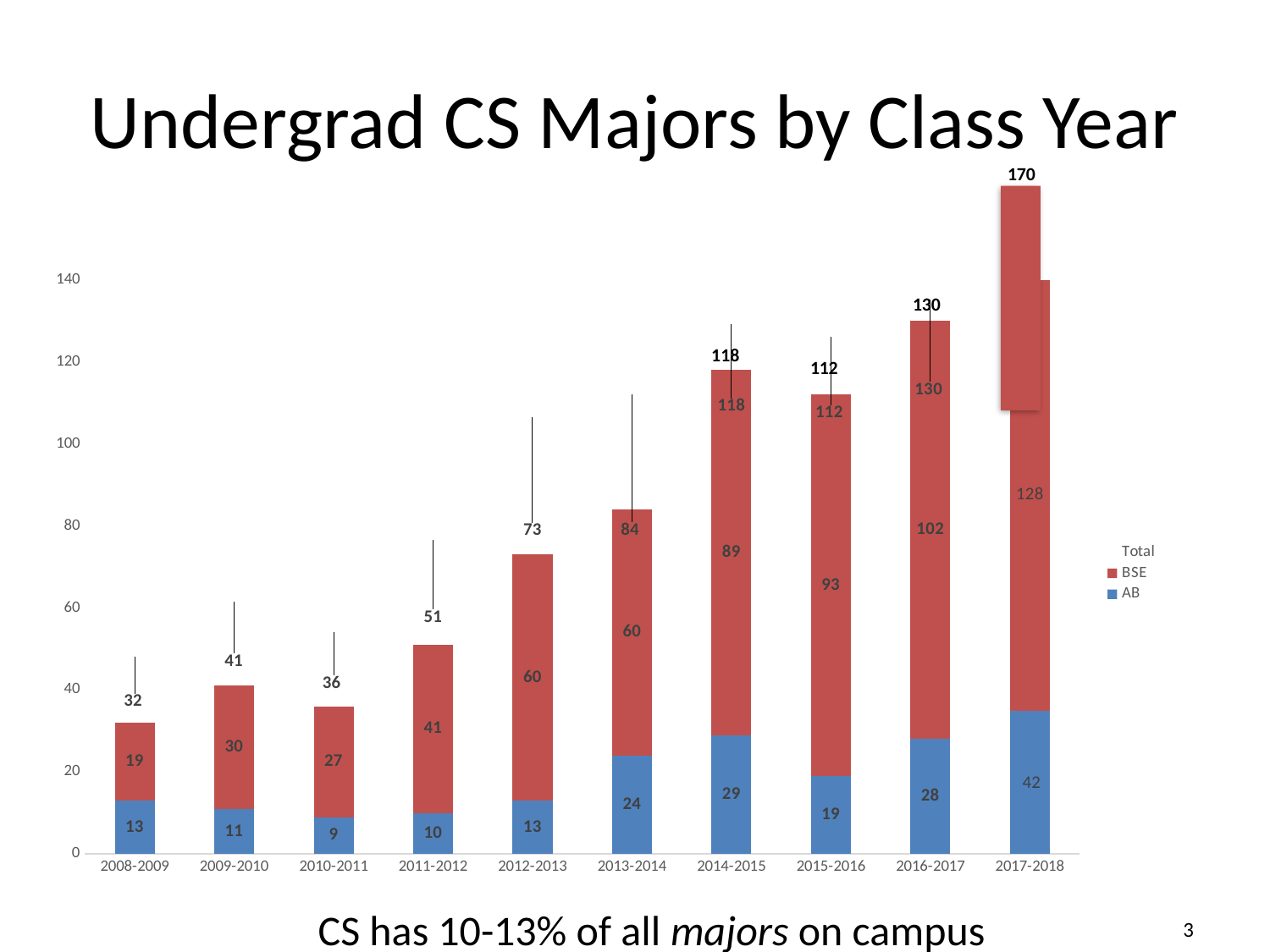
Which class year has the highest total? 2017-2018 How many entries does the legend list? 3 What is the BSE value for 2016-2017? 102 What is the title of the chart? Undergrad CS Majors by Class Year Which class year has the lowest AB value? 2010-2011 What is the AB value for 2013-2014? 24 Which is larger, the AB value for 2014-2015 or the AB value for 2015-2016? 2014-2015 Is the total for 2012-2013 greater or less than 80? less How many class years are shown on the x axis? 10 What is the difference between the BSE values for 2015-2016 and 2014-2015? 4 What kind of chart is shown on the slide? stacked bar chart What is the total number of CS majors shown for 2011-2012? 51